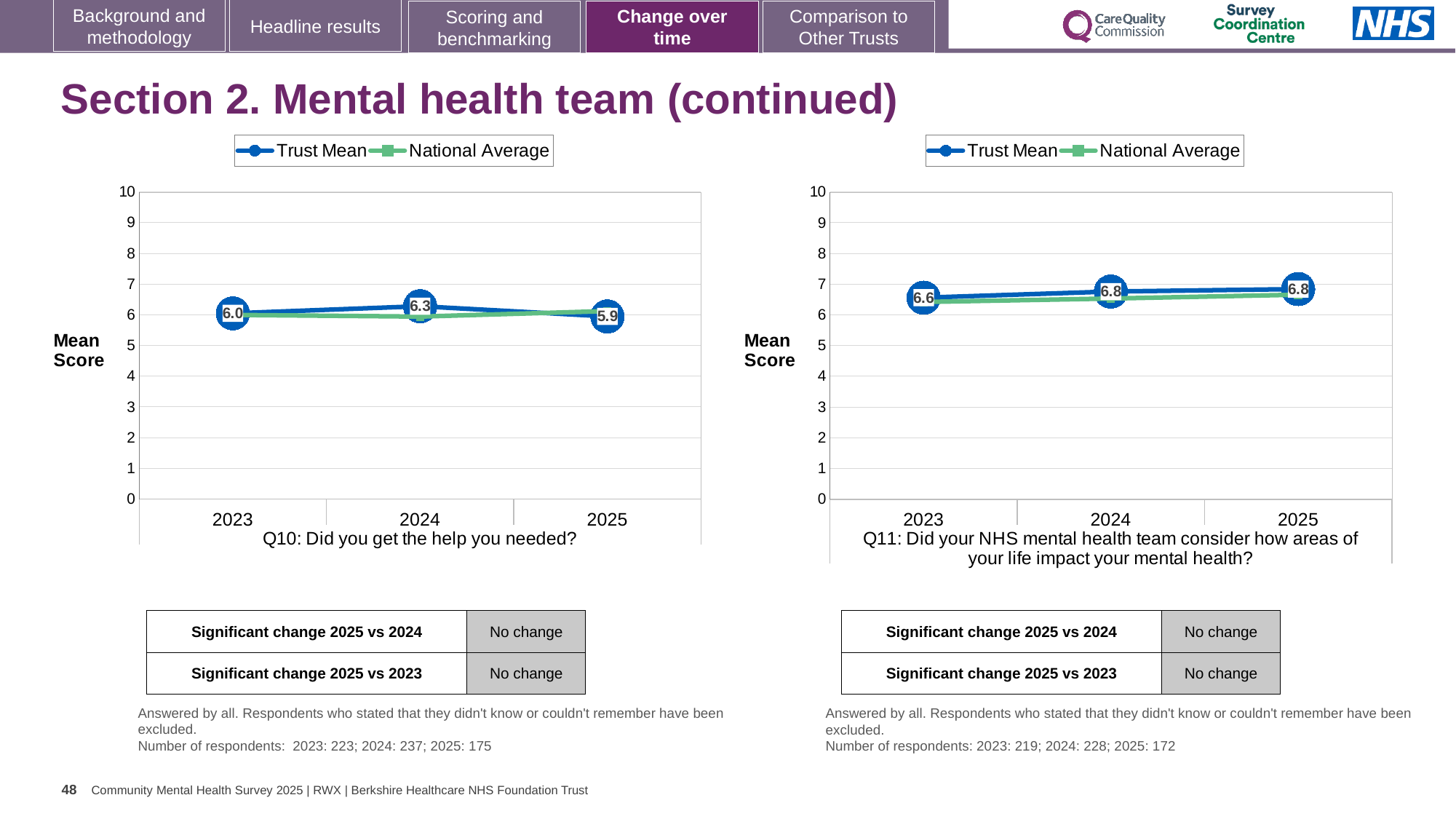
How many series does the legend of the Q11 chart (right) list? 2 In the Q10 chart (left), which year has the highest Trust Mean? 2024 How many years are plotted on the x axis of the Q10 chart (left)? 3 In the Q11 chart (right), is the Trust Mean for 2025 larger or smaller than for 2023? larger In the Q11 chart (right), does the Trust Mean rise or fall from 2023 to 2025? rise In the Q11 chart (right), what is the Trust Mean for 2023? 6.6 What kind of chart is the Q10 chart (left)? line chart In the Q10 chart (left), what is the Trust Mean for 2024? 6.3 In the Q11 chart (right), is the National Average for 2023 greater or less than 7? less In the Q11 chart (right), which year has the lowest Trust Mean? 2023 In the Q10 chart (left), what is the difference between the Trust Mean for 2024 and 2025? 0.4 In the Q10 chart (left), what is the Trust Mean for 2025? 5.9